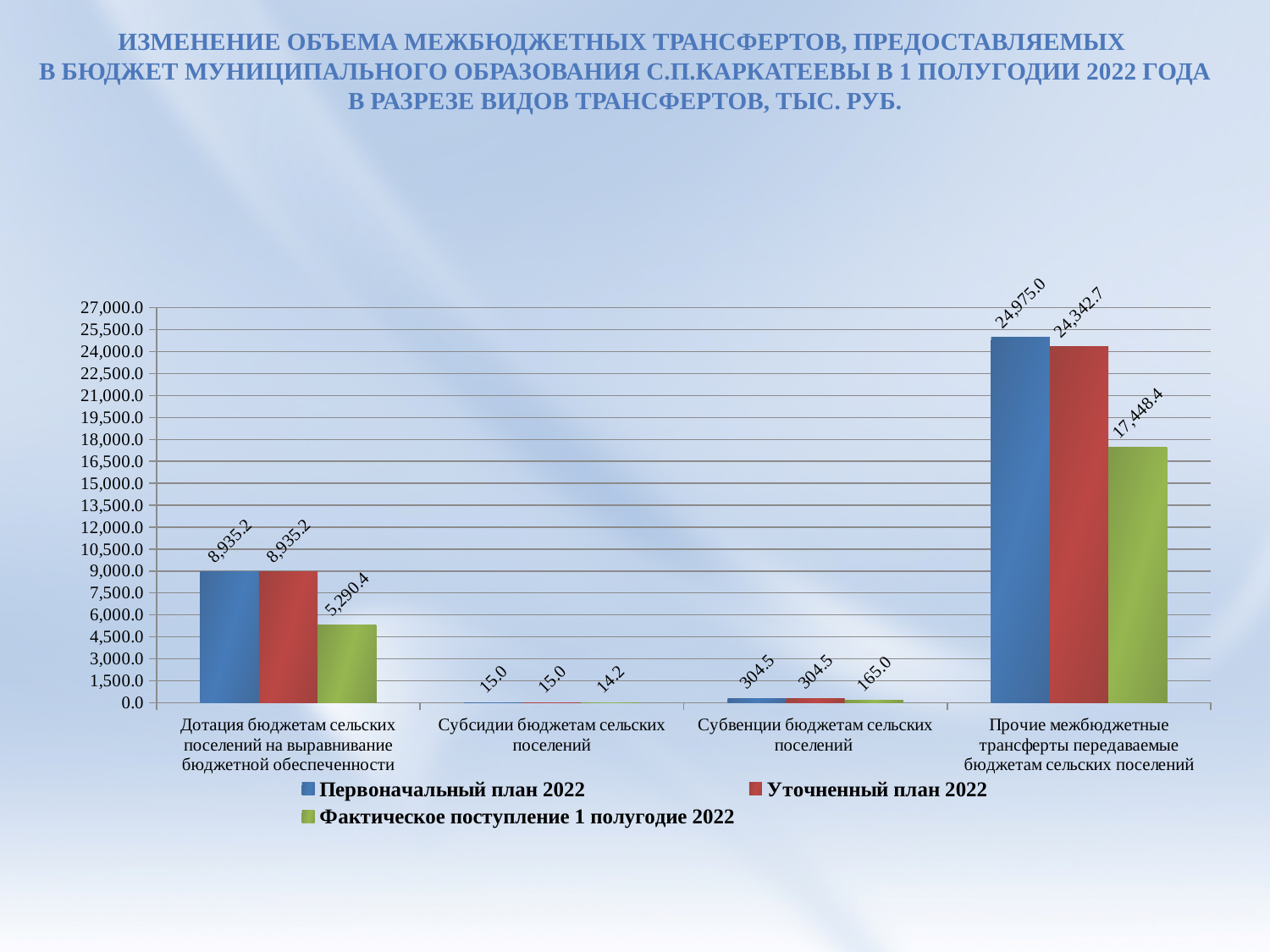
What is the value of Фактическое поступление 1 полугодие 2022 for Дотация бюджетам сельских поселений на выравнивание бюджетной обеспеченности? 5,290.4 Which category has the highest value for Уточненный план 2022? Прочие межбюджетные трансферты передаваемые бюджетам сельских поселений What is the value of Фактическое поступление 1 полугодие 2022 for Субсидии бюджетам сельских поселений? 14.2 Which is larger for Субвенции бюджетам сельских поселений: Уточненный план 2022 or Фактическое поступление 1 полугодие 2022? Уточненный план 2022 What is the difference between Уточненный план 2022 and Фактическое поступление 1 полугодие 2022 for Дотация бюджетам сельских поселений на выравнивание бюджетной обеспеченности? 3,644.8 What kind of chart is shown on the slide? Bar chart Which category has the lowest value for Первоначальный план 2022? Субсидии бюджетам сельских поселений How many series does the legend list? 3 How many categories are shown on the x axis? 4 What is the value of Уточненный план 2022 for Субвенции бюджетам сельских поселений? 304.5 What is the difference between Первоначальный план 2022 and Уточненный план 2022 for Прочие межбюджетные трансферты передаваемые бюджетам сельских поселений? 632.3 What is the value of Первоначальный план 2022 for Прочие межбюджетные трансферты передаваемые бюджетам сельских поселений? 24,975.0